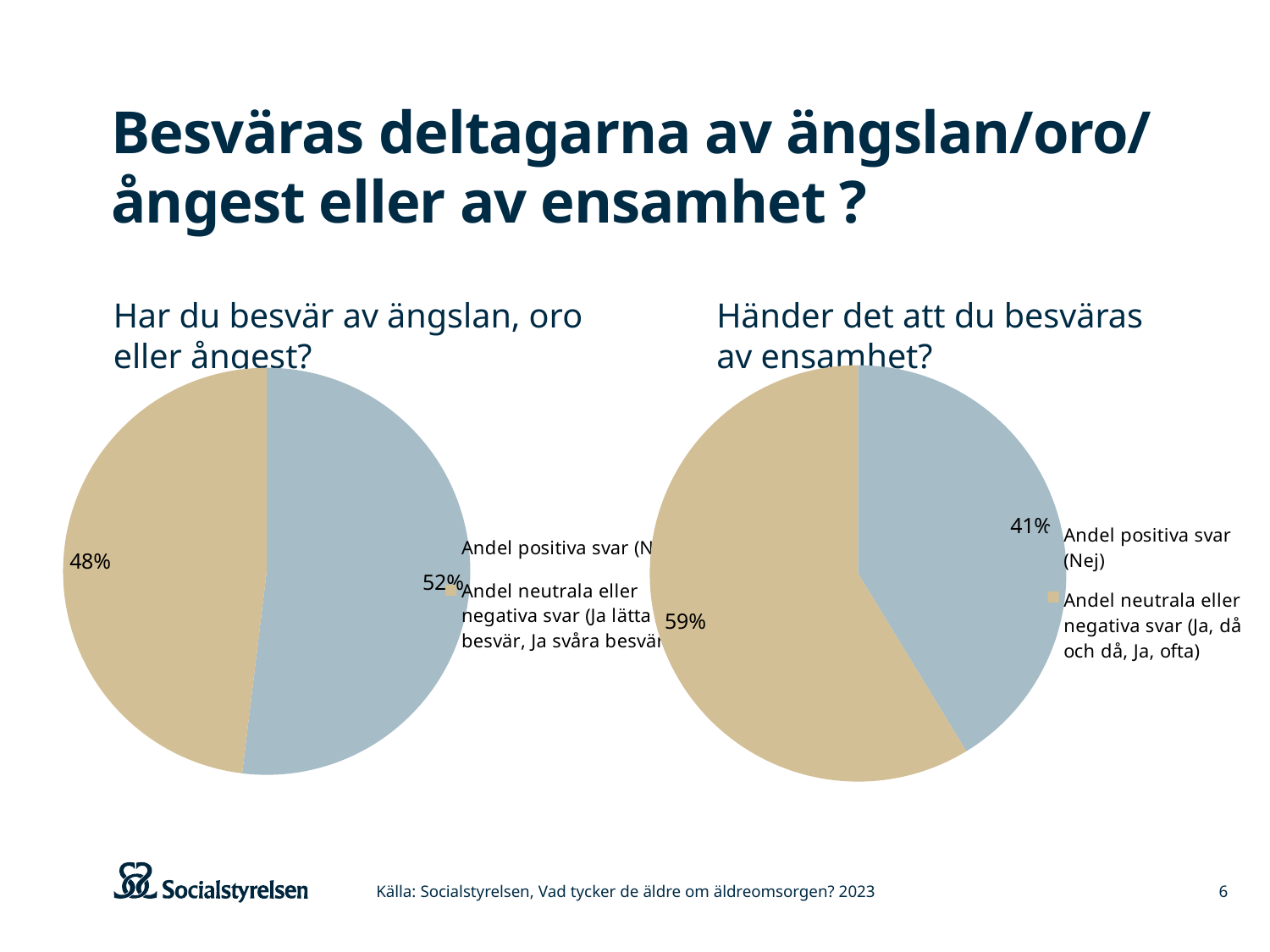
In the chart 'Har du besvär av ängslan, oro eller ångest?', what share of answers are positive (Nej)? 52% Which is larger: the positive (Nej) share in the left chart about ängslan, oro eller ångest, or the positive (Nej) share in the right chart about ensamhet? The left chart (52%) In the chart 'Händer det att du besväras av ensamhet?', what colour is the slice for 'Andel positiva svar (Nej)'? Blue-grey In the chart 'Har du besvär av ängslan, oro eller ångest?', which slice is the smallest? Andel neutrala eller negativa svar How many legend entries does the chart 'Händer det att du besväras av ensamhet?' list? 2 How many slices does each pie chart on the slide have? 2 In the chart 'Händer det att du besväras av ensamhet?', which slice is the largest? Andel neutrala eller negativa svar (Ja, då och då, Ja, ofta) In the chart 'Har du besvär av ängslan, oro eller ångest?', what share of answers are neutral or negative? 48% In the chart 'Händer det att du besväras av ensamhet?', what share of answers are neutral or negative (Ja, då och då, Ja, ofta)? 59% What kind of charts are shown on the slide? Pie charts In the chart 'Händer det att du besväras av ensamhet?', what share of answers are positive (Nej)? 41% In the chart 'Händer det att du besväras av ensamhet?', what is the difference between the neutral/negative share and the positive share? 18 percentage points